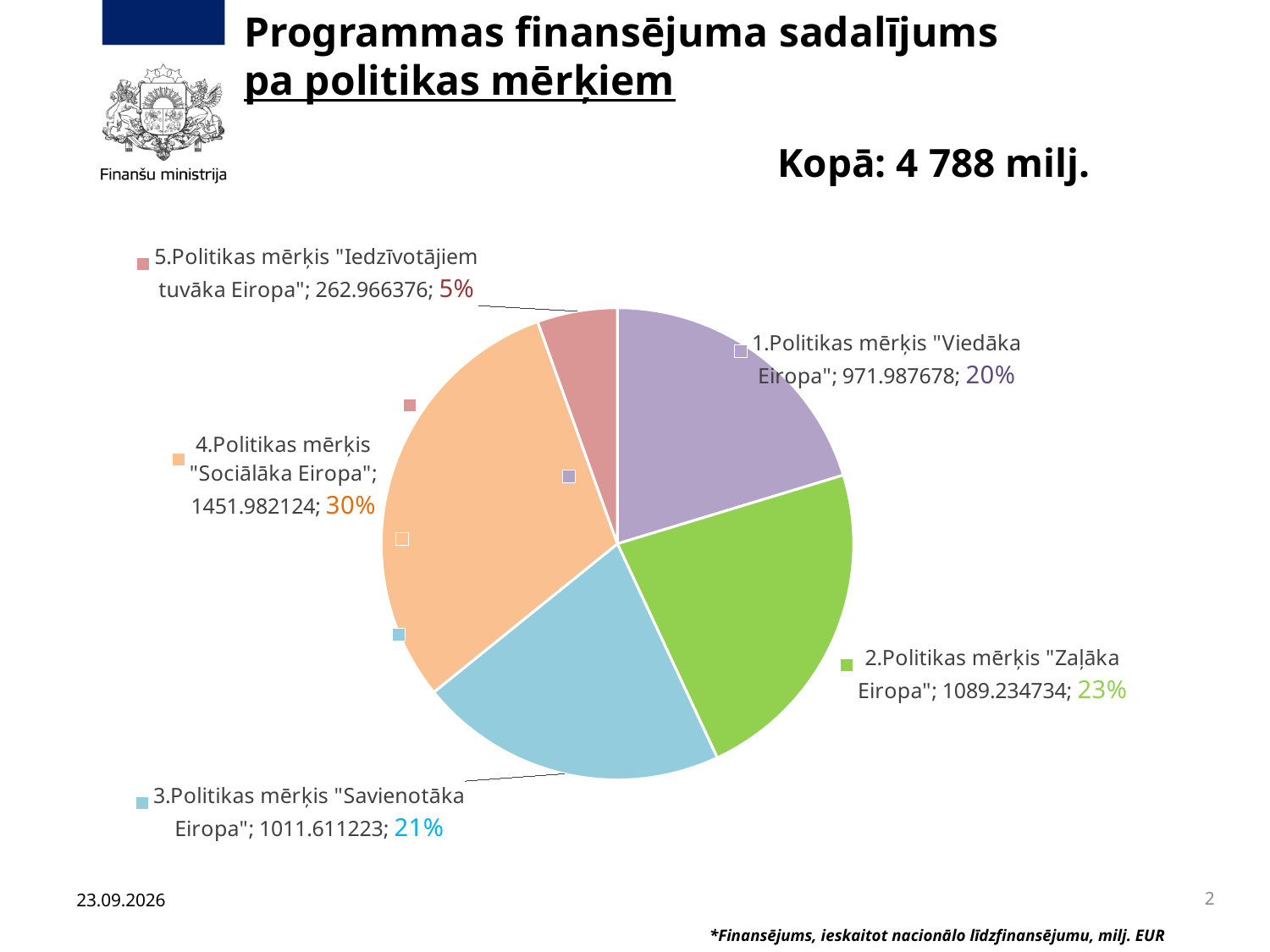
Which policy objective has the smallest share of the pie? 5.Politikas mērķis "Iedzīvotājiem tuvāka Eiropa" What is the difference in percentage share between 4.Politikas mērķis "Sociālāka Eiropa" and 5.Politikas mērķis "Iedzīvotājiem tuvāka Eiropa"? 25% What percentage share does 3.Politikas mērķis "Savienotāka Eiropa" have? 21% What kind of chart is shown on the slide? pie chart What is the value for 5.Politikas mērķis "Iedzīvotājiem tuvāka Eiropa"? 262.966376 What colour is the slice for 2.Politikas mērķis "Zaļāka Eiropa"? green What total is stated on the slide for the programme funding? Kopā: 4 788 milj. What is the value for 4.Politikas mērķis "Sociālāka Eiropa"? 1451.982124 How many slices does the pie chart have? 5 What percentage share does 1.Politikas mērķis "Viedāka Eiropa" have? 20% Which has the larger value: 2.Politikas mērķis "Zaļāka Eiropa" or 3.Politikas mērķis "Savienotāka Eiropa"? 2.Politikas mērķis "Zaļāka Eiropa" Which policy objective has the largest share of the pie? 4.Politikas mērķis "Sociālāka Eiropa"